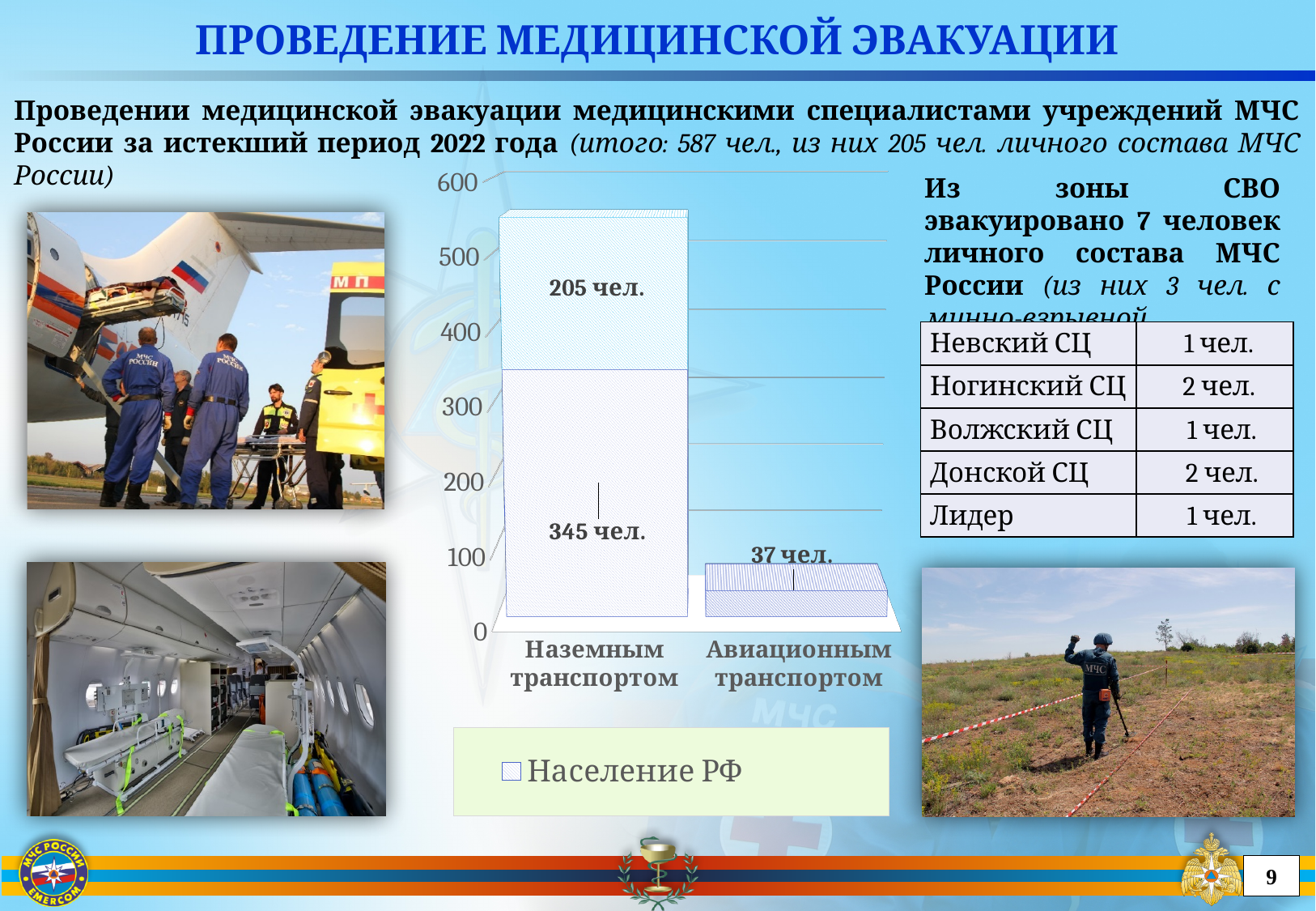
What is the value of the upper (hatched) segment of the "Наземным транспортом" bar? 205 чел. What is the total of the stacked bar for "Наземным транспортом"? 550 чел. Which category has the lowest bar in the chart? Авиационным транспортом What is the highest value shown on the chart's vertical axis? 600 Is the total bar for "Наземным транспортом" greater or less than 500? greater What is the difference between the two segments of the "Наземным транспортом" bar (345 чел. and 205 чел.)? 140 чел. What kind of chart is shown on the slide? bar chart Is the total bar for "Авиационным транспортом" greater or less than 100? less Which category has the taller bar, "Наземным транспортом" or "Авиационным транспортом"? Наземным транспортом What series name is shown in the chart legend? Население РФ How many categories are shown on the x axis of the chart? 2 What is the value of the "Население РФ" segment for "Наземным транспортом"? 345 чел.